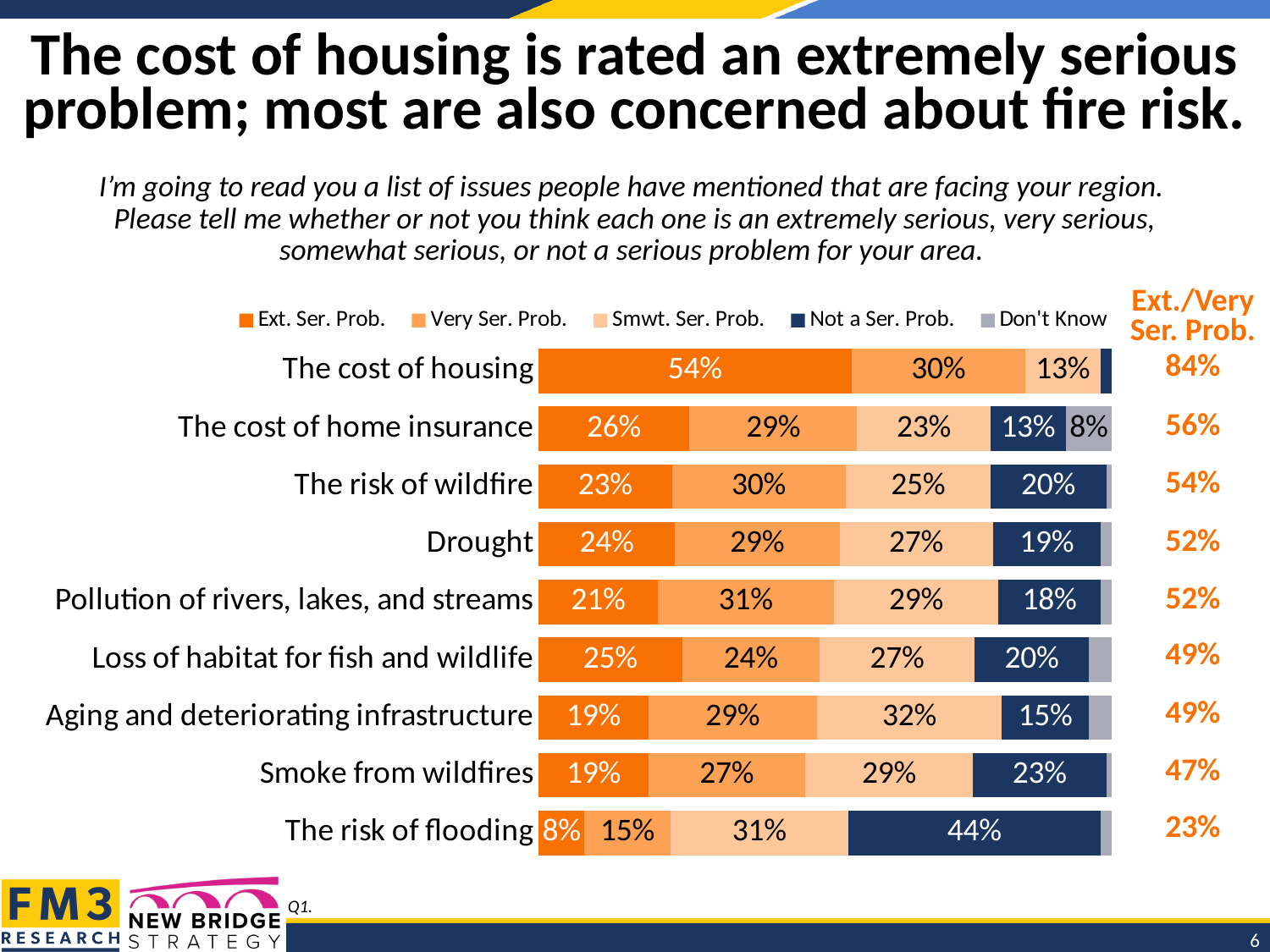
What percentage rated the cost of housing an extremely serious problem? 54% What is the difference between the extremely serious percentages for the cost of housing and the cost of home insurance? 28% What percentage answered 'Don't Know' for the cost of home insurance? 8% Which has a larger 'Not a serious problem' share: smoke from wildfires or drought? Smoke from wildfires Which issue has the highest combined extremely/very serious problem percentage? The cost of housing What type of chart is shown on the slide? Stacked bar chart How many response categories does the legend list? 5 How many issues are listed in the chart? 9 What is the combined extremely/very serious problem percentage for the risk of wildfire? 54% Which response category is shown in dark navy blue in the legend? Not a Ser. Prob. What percentage said the risk of flooding is not a serious problem? 44% Which issue has the lowest combined extremely/very serious problem percentage? The risk of flooding